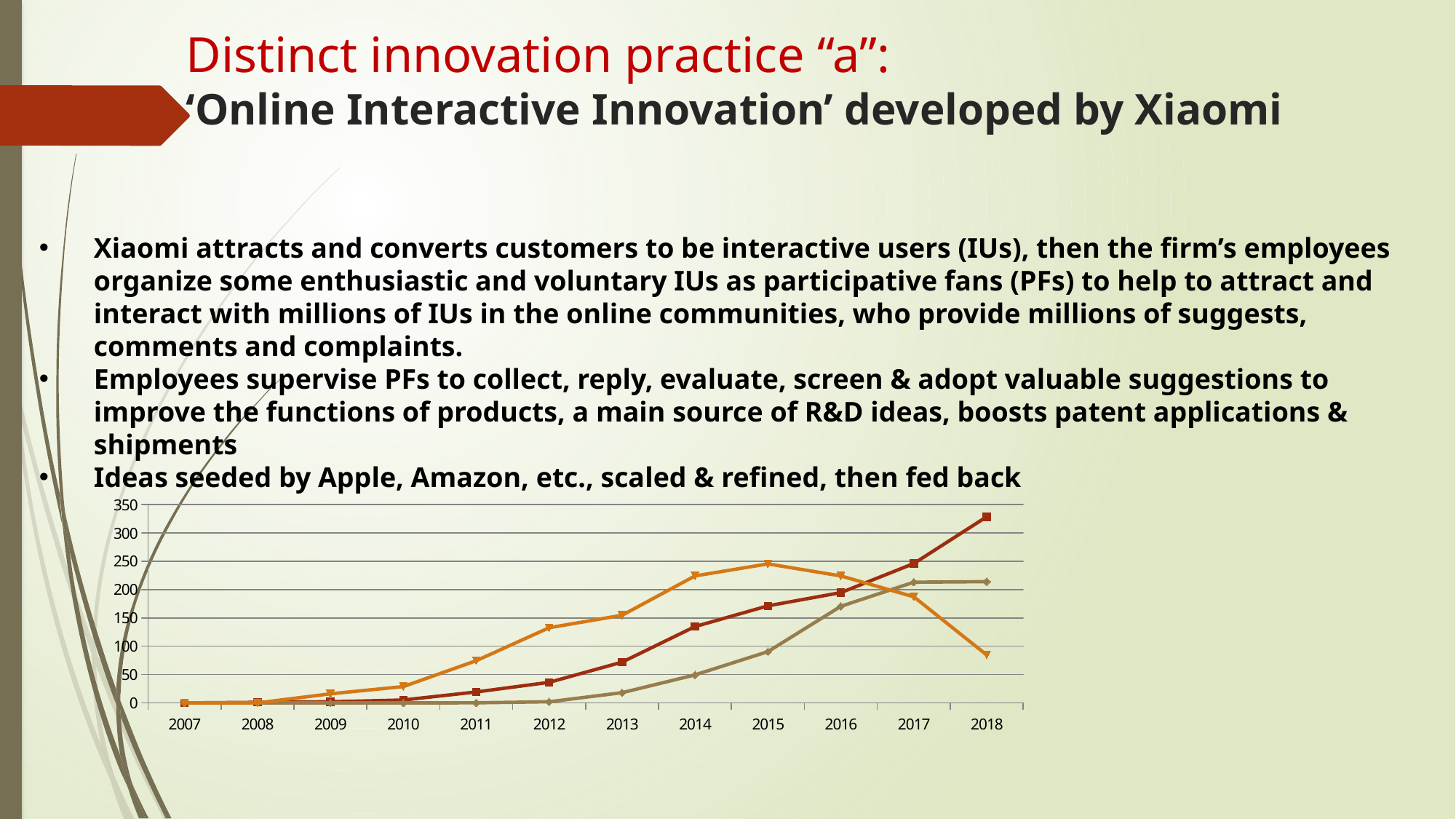
In 2018, which line is higher: the dark red line (square markers) or the orange line (triangle markers)? the dark red line Is the value of the orange line (triangle markers) in 2015 greater or less than 200? greater Is the value of the tan line (diamond markers) in 2013 greater or less than 50? less Does the orange line (triangle markers) rise or fall from 2015 to 2018? fall How many years are shown along the x axis of the chart? 12 Is the value of the dark red line (square markers) in 2018 greater or less than 300? greater In 2014, which line is higher: the orange line (triangle markers) or the tan line (diamond markers)? the orange line What is the highest value shown on the chart's y axis? 350 In which year does the orange line (triangle markers) reach its highest value? 2015 Does the dark red line (square markers) generally rise or fall from 2007 to 2018? rise What kind of chart is shown on the slide? line chart